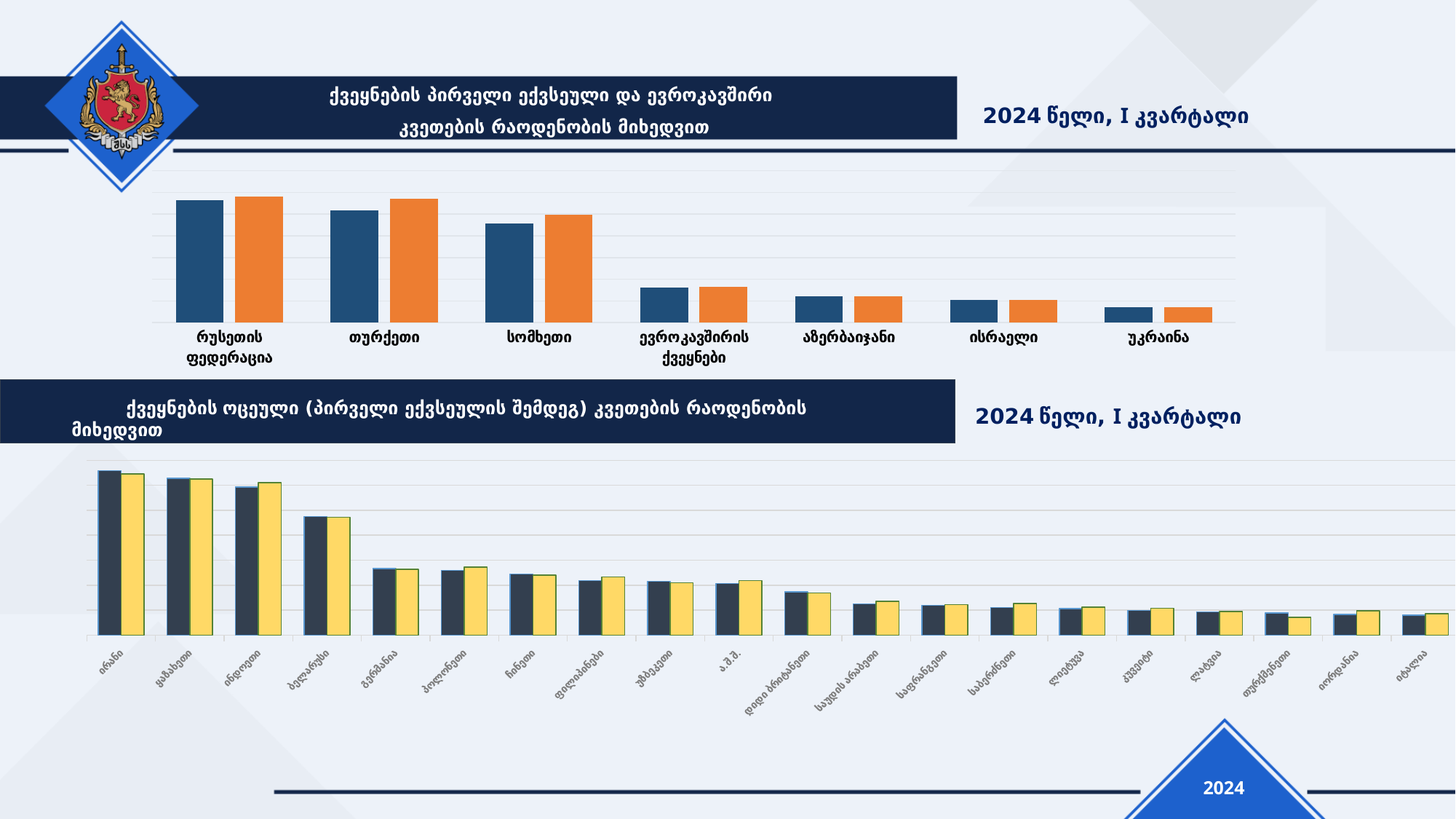
In the top chart, which category has the highest bars? რუსეთის ფედერაცია In the bottom chart, do the values generally rise or fall from left to right along the x axis? fall In the top chart, do the values generally rise or fall from left to right along the x axis? fall In the top chart, which is larger, the value for თურქეთი or the value for აზერბაიჯანი? თურქეთი In the bottom chart, how many countries are shown on the x axis? 20 What kind of chart is the bottom chart on the slide? bar chart Which year and quarter do both charts on the slide refer to? 2024 წელი, I კვარტალი In the bottom chart, which is larger, the value for ბელარუსი or the value for გერმანია? ბელარუსი In the top chart, which category has the lowest bars? უკრაინა What kind of chart is the top chart on the slide? bar chart In the bottom chart, which country has the highest bars? ირანი In the top chart, how many countries/categories are shown on the x axis? 7